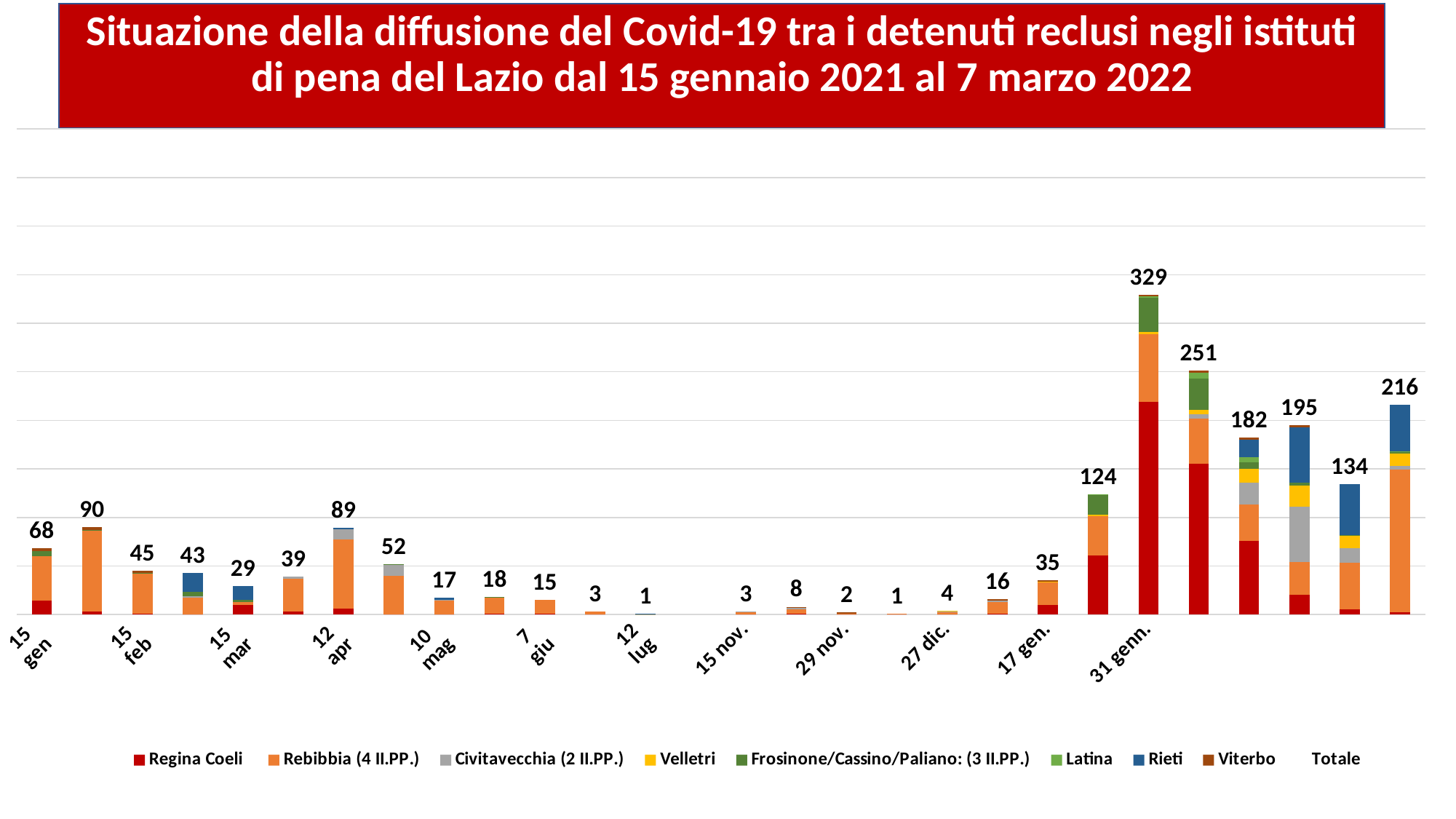
What is the difference between the totals for 31 genn. and 12 apr? 240 Which has a larger total, 15 feb or 12 apr? 12 apr What is the total value shown for 31 genn.? 329 Do the totals rise or fall from 15 gen to 15 mar? fall What kind of chart is shown? stacked bar chart What is the total value shown for 15 gen? 68 What is the total value shown for 12 apr? 89 Which date has the highest total? 31 genn. What colour represents Regina Coeli in the chart? red What is the total value shown for 17 gen.? 35 How many entries does the legend list? 9 What is the total value shown for 15 mar? 29